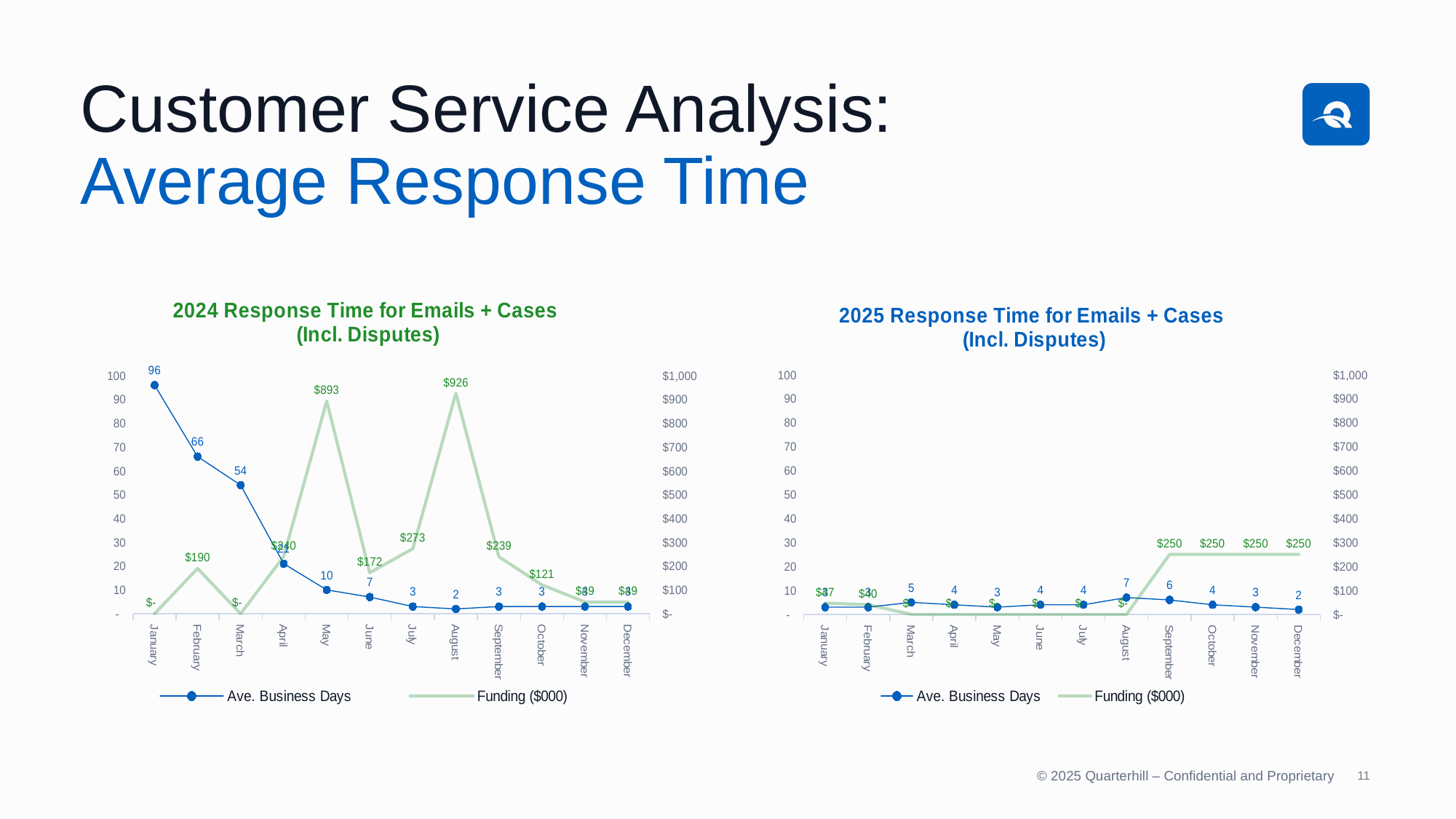
In the 2025 Response Time for Emails + Cases chart, which month has the highest Ave. Business Days value? August How many series does the legend of the 2025 Response Time for Emails + Cases chart list? 2 In the 2024 Response Time for Emails + Cases chart, what is the difference between the Ave. Business Days values for January and February? 30 In the 2024 Response Time for Emails + Cases chart, what is the Funding ($000) value for August? $926 In the 2025 Response Time for Emails + Cases chart, what is the Funding ($000) value for September? $250 In the 2024 Response Time for Emails + Cases chart, what is the difference between the Funding ($000) values for May and June? $721 In the 2025 Response Time for Emails + Cases chart, what is the Ave. Business Days value for August? 7 In the 2024 Response Time for Emails + Cases chart, what is the Ave. Business Days value for January? 96 In the 2024 Response Time for Emails + Cases chart, which month has the highest Funding ($000) value? August In the 2024 Response Time for Emails + Cases chart, which is larger, the Ave. Business Days value for February or for March? February In the 2024 Response Time for Emails + Cases chart, does the Ave. Business Days line rise or fall from January to August? fall What kind of chart is the 2024 Response Time for Emails + Cases chart? line chart